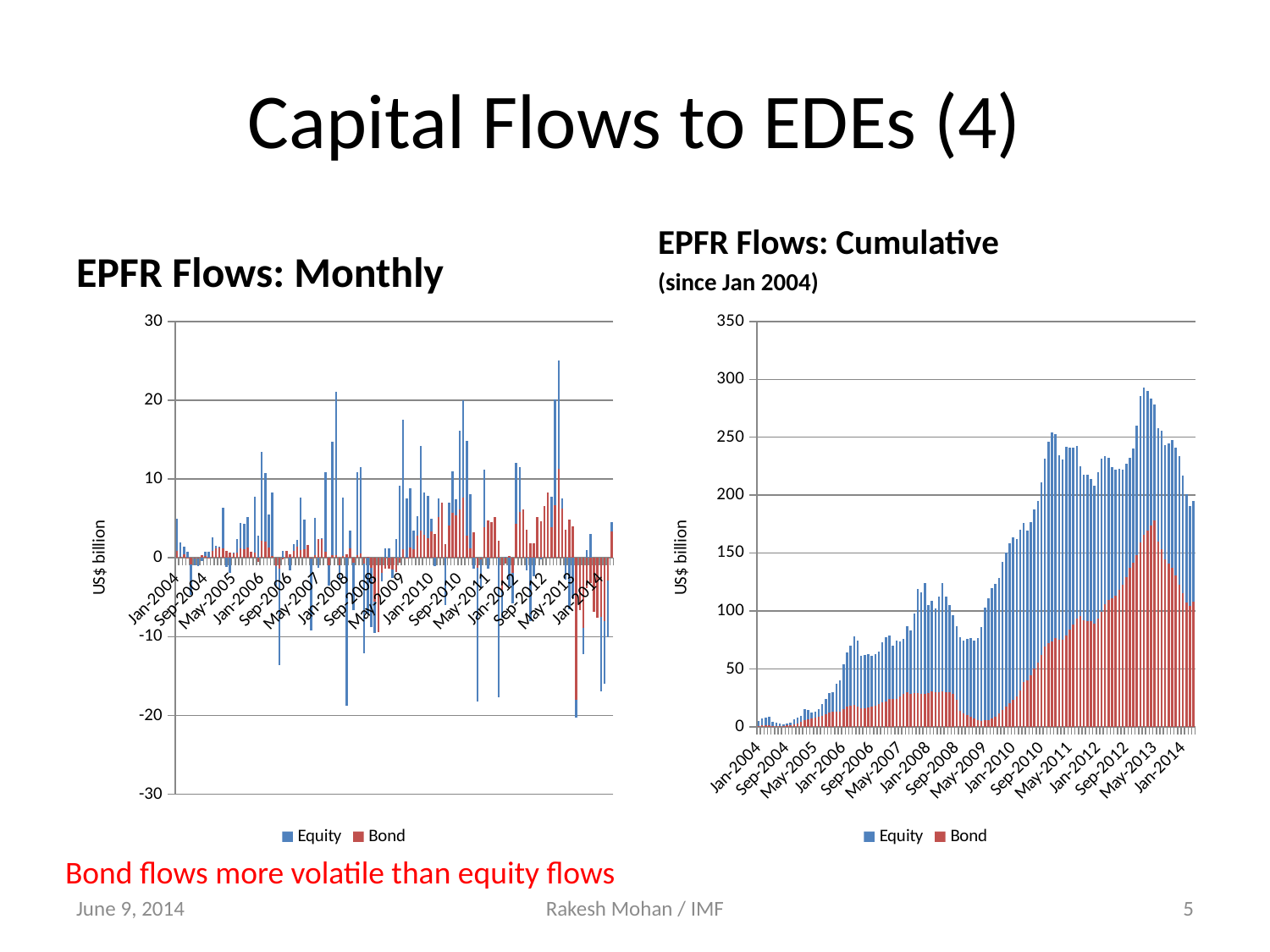
In the 'EPFR Flows: Cumulative' chart, is the total around Jan 2008 greater or less than 150? less How many series does the legend of the 'EPFR Flows: Monthly' chart list? 2 In the 'EPFR Flows: Monthly' chart, is the highest Equity bar greater or less than 20? greater Which two series are shown in the legend of the 'EPFR Flows: Cumulative' chart? Equity and Bond In the 'EPFR Flows: Cumulative' chart, which series accounts for the larger share of the total around Jan 2006, Equity or Bond? Equity What is the y-axis label on the 'EPFR Flows: Cumulative' chart? US$ billion In the 'EPFR Flows: Cumulative' chart, is the highest total bar greater or less than 250? greater What is the maximum value shown on the y-axis of the 'EPFR Flows: Monthly' chart? 30 What kind of chart is the 'EPFR Flows: Cumulative' chart on the right? bar chart In the 'EPFR Flows: Cumulative' chart, do the cumulative flows overall rise or fall from Jan 2004 to 2014? rise What kind of chart is the 'EPFR Flows: Monthly' chart on the left? bar chart